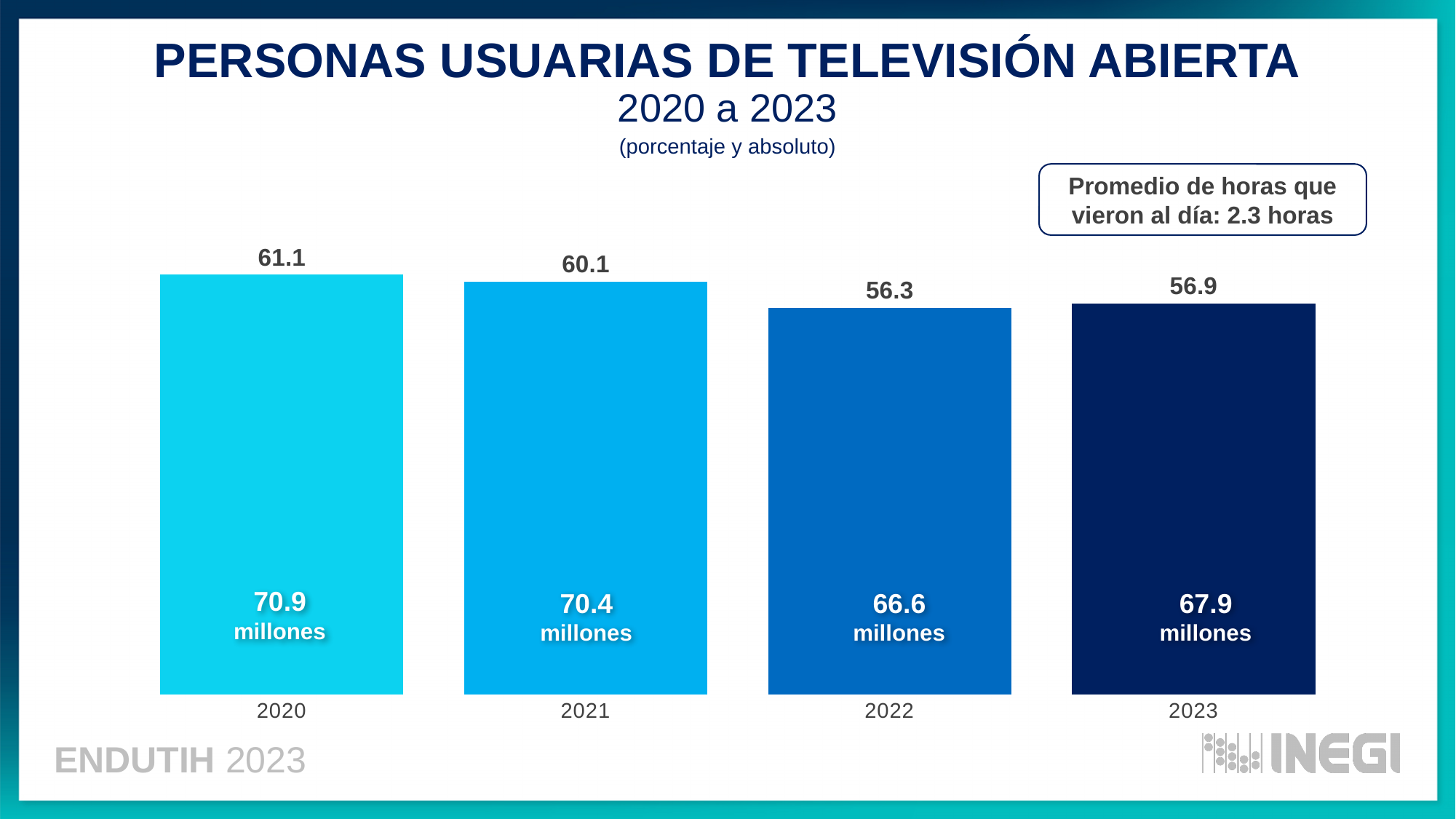
Does the percentage of open television users rise or fall from 2020 to 2022? Fall What is the absolute number of open television users shown for 2022? 66.6 millones What type of chart is shown on the slide? Bar chart What percentage of people used open television in 2020? 61.1 Which year has the lowest percentage of open television users? 2022 How many years are shown in the chart? 4 According to the text box on the slide, what was the average number of hours watched per day? 2.3 horas Which year has the highest percentage of open television users? 2020 Which year has more users in absolute terms, 2022 or 2023? 2023 What percentage is shown for 2023? 56.9 What is the difference in percentage points between 2020 and 2023? 4.2 What is the difference in millions of users between 2021 and 2022? 3.8 millones